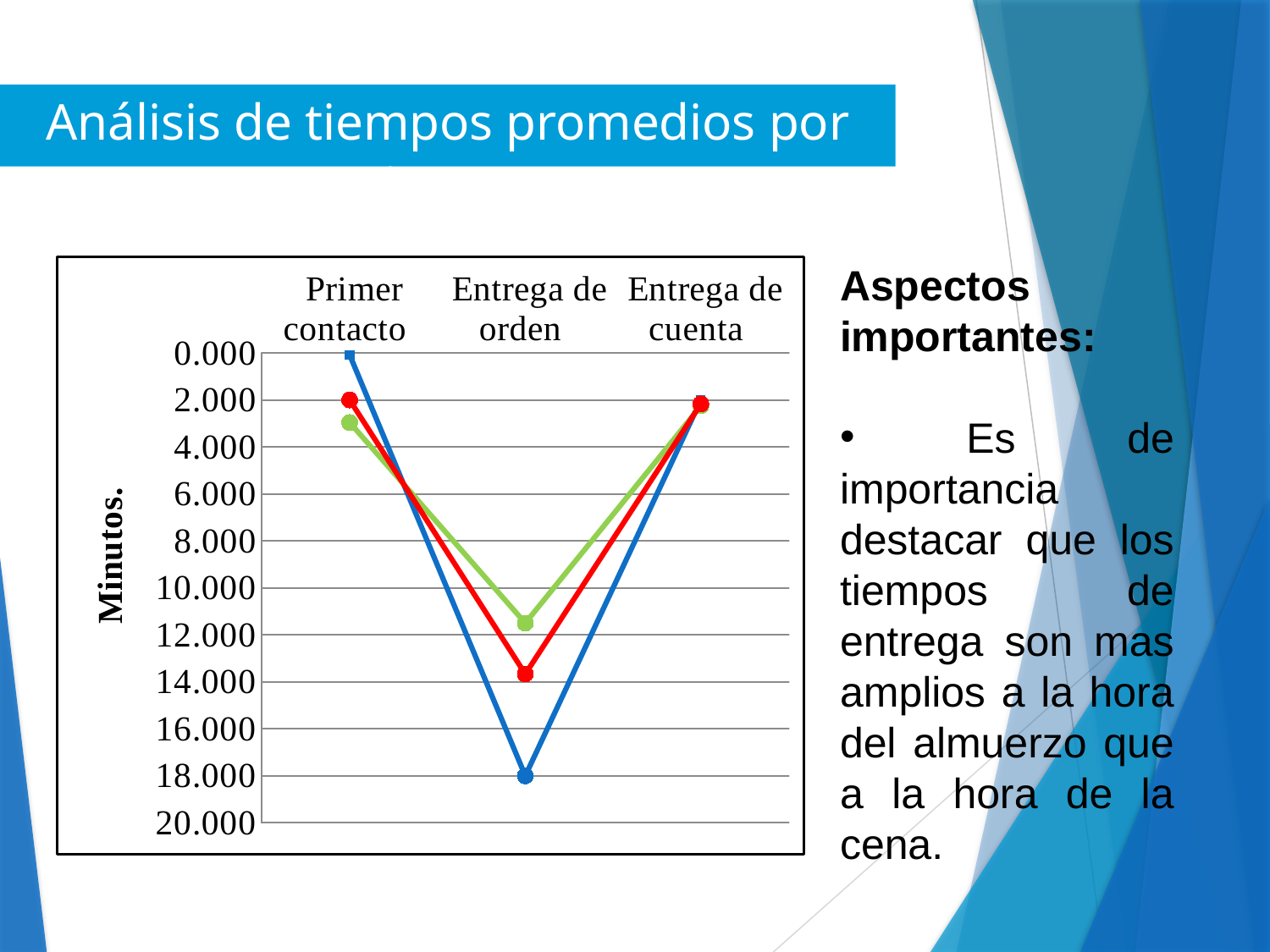
Is the value of the green line for Primer contacto greater or less than 4.000? less At Primer contacto, which line has the larger value in minutes, the red line or the green line? the green line For the blue line, which category has the highest value in minutes? Entrega de orden Is the value of the green line for Entrega de orden greater or less than 10.000? greater Is the value of the blue line for Entrega de orden greater or less than 16.000? greater How many categories are shown on the x axis of the chart? 3 What is the title of the vertical axis of the chart? Minutos. What kind of chart is shown on the slide? line chart At Entrega de orden, which line has the larger value in minutes, the blue line or the green line? the blue line How many lines are plotted on the chart? 3